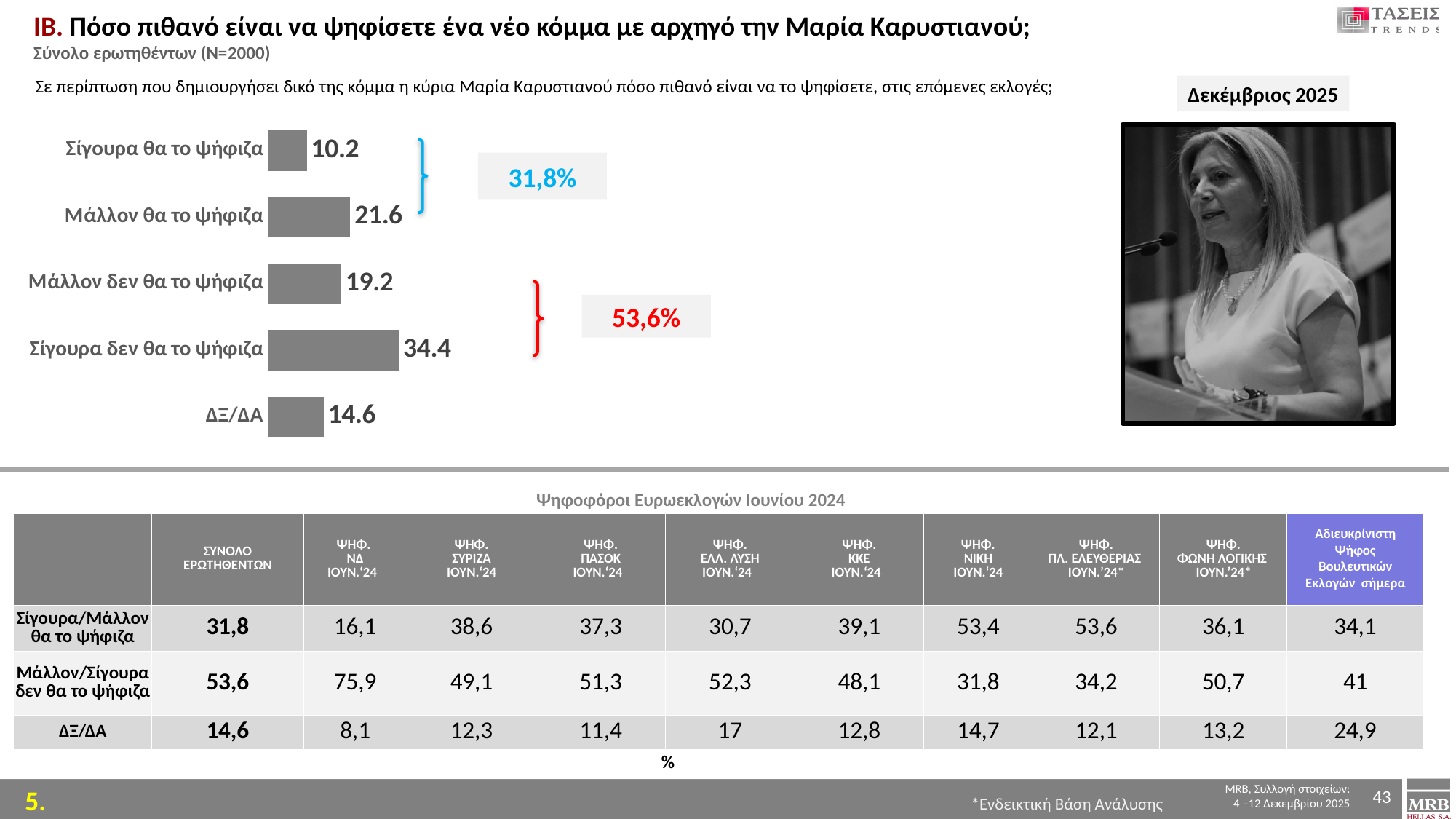
How many categories are shown in the bar chart? 5 What is the value for "Σίγουρα δεν θα το ψήφιζα"? 34.4 Which category has the highest value? Σίγουρα δεν θα το ψήφιζα What is the value for "Μάλλον θα το ψήφιζα"? 21.6 What is the value for "Σίγουρα θα το ψήφιζα"? 10.2 What is the difference between "Σίγουρα δεν θα το ψήφιζα" and "Μάλλον δεν θα το ψήφιζα"? 15.2 What is the combined total of "Σίγουρα θα το ψήφιζα" and "Μάλλον θα το ψήφιζα"? 31.8 What kind of chart is shown on the slide? Bar chart What percentage is shown in the red-bracketed annotation next to the chart? 53,6% What is the value for "ΔΞ/ΔΑ"? 14.6 Which category has the lowest value? Σίγουρα θα το ψήφιζα Which is larger, "Μάλλον θα το ψήφιζα" or "Μάλλον δεν θα το ψήφιζα"? Μάλλον θα το ψήφιζα